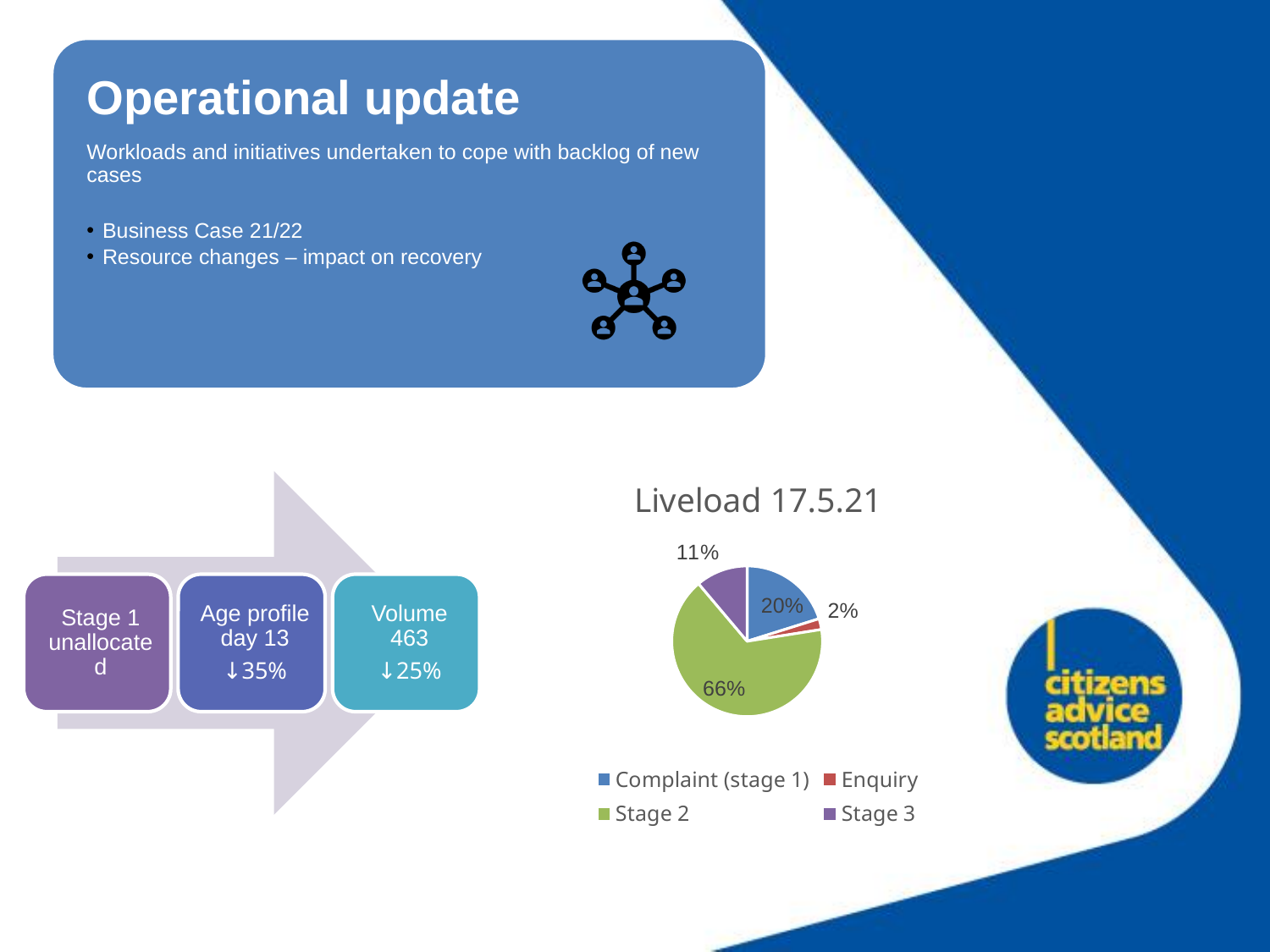
What colour is the Stage 2 slice in the pie chart? Green Which category has the largest slice of the pie chart? Stage 2 What kind of chart is shown under the title "Liveload 17.5.21"? Pie chart What percentage of the pie chart is Enquiry? 2% What percentage of the pie chart is Complaint (stage 1)? 20% In the pie chart, which is larger: Complaint (stage 1) or Stage 3? Complaint (stage 1) What percentage of the pie chart is Stage 3? 11% What percentage of the pie chart is Stage 2? 66% Which category has the smallest slice of the pie chart? Enquiry In the pie chart, what is the difference between the Stage 2 share and the Complaint (stage 1) share? 46% How many categories does the pie chart legend list? 4 What is the title of the pie chart? Liveload 17.5.21